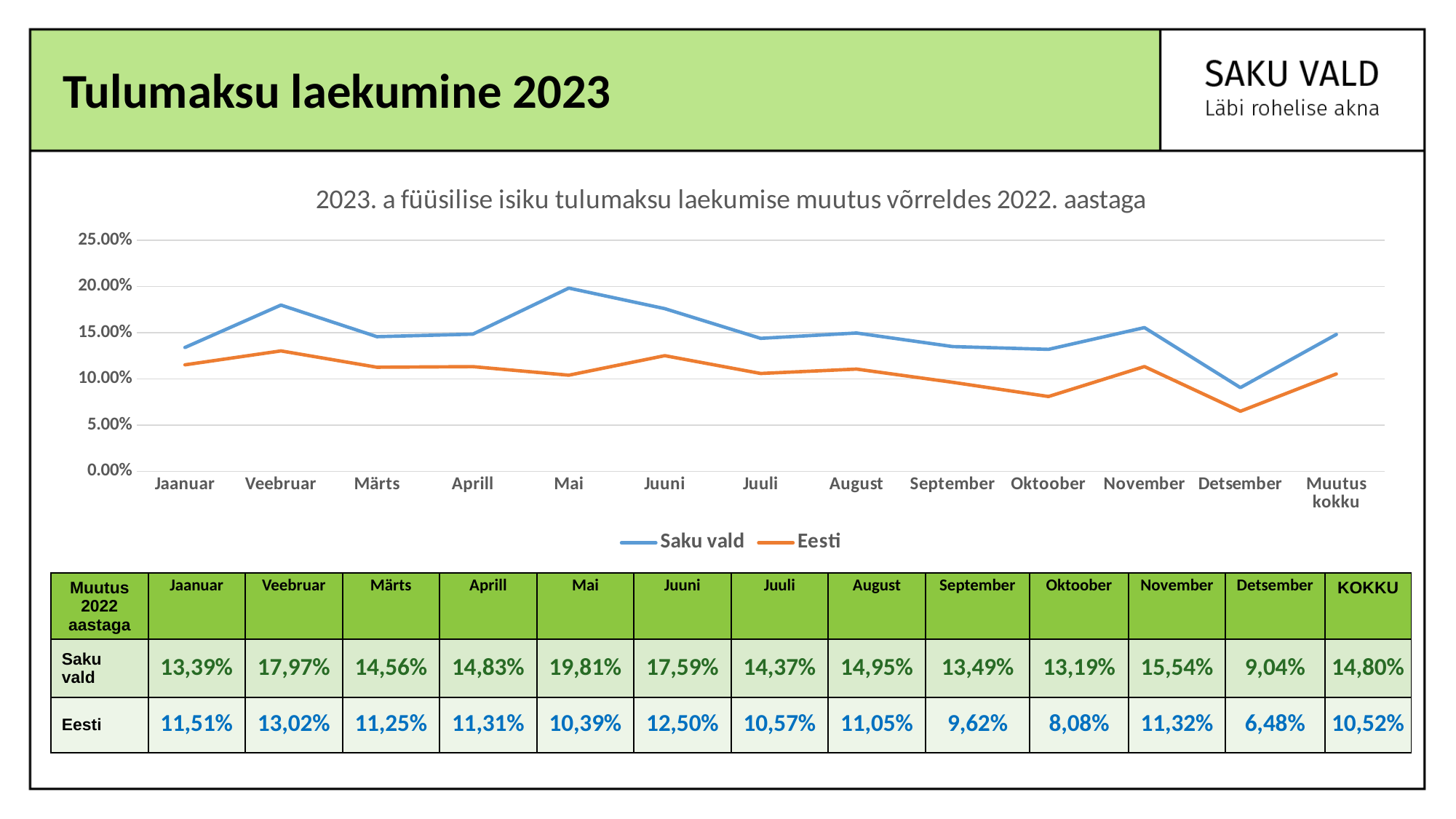
What is the title of the chart? 2023. a füüsilise isiku tulumaksu laekumise muutus võrreldes 2022. aastaga What is the value for Eesti in Juuni? 12,50% In which month is the Eesti value lowest? Detsember How many series does the chart legend list? 2 Is the Saku vald value for Detsember greater or less than 10.00%? less What is the value for Eesti in Detsember? 6,48% What is the value for Saku vald in Mai? 19,81% What kind of chart is shown on the slide? line chart In which month is the Saku vald value highest? Mai How many categories are shown along the x axis of the chart? 13 What is the difference between the Saku vald and Eesti values in Mai? 9,42% Which series has the higher value in Veebruar, Saku vald or Eesti? Saku vald